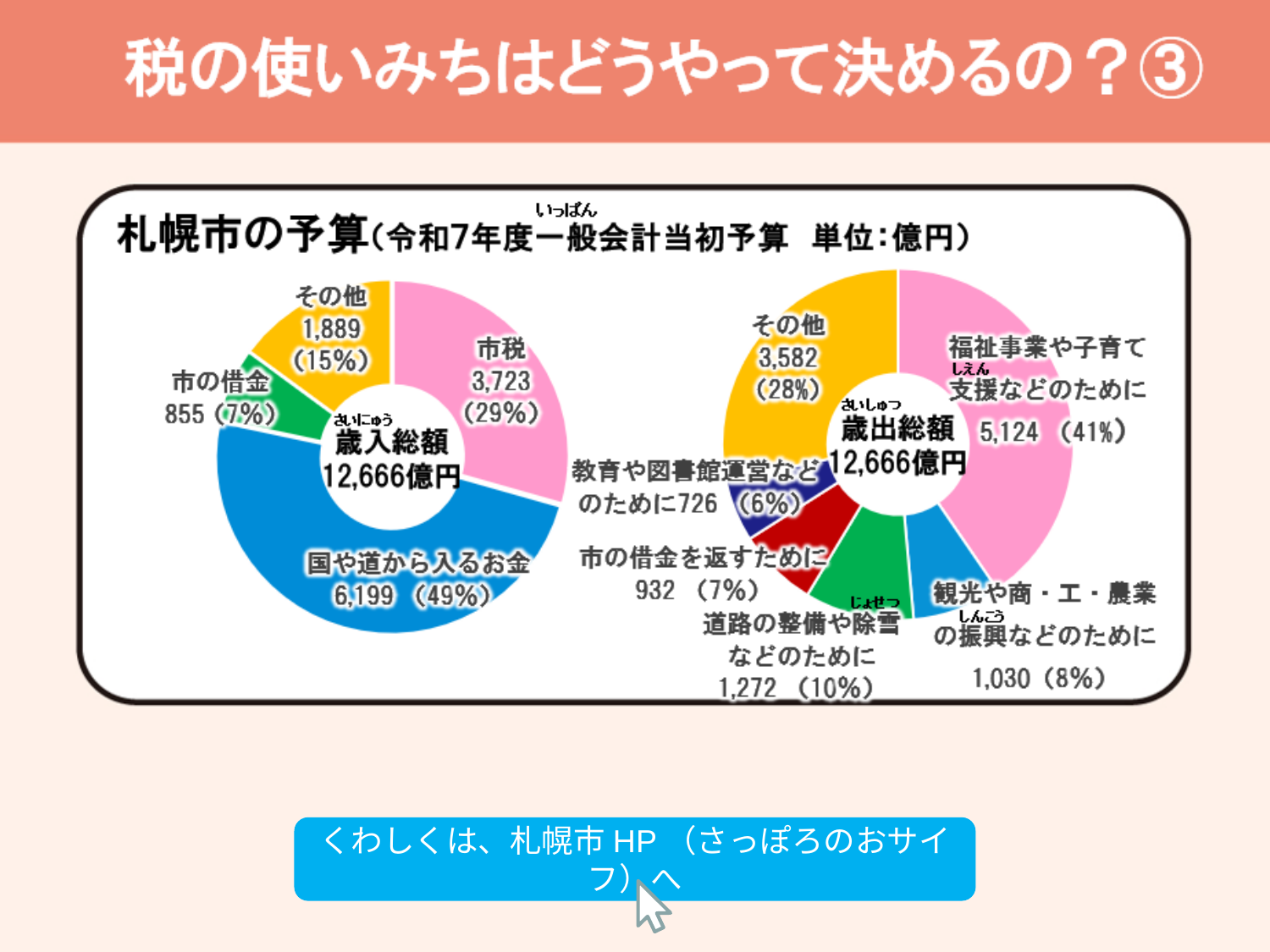
In the 歳出 chart on the right, what share of the total is その他? 28% In the 歳入 chart on the left, what is the difference between 国や道から入るお金 and 市税? 2,476 In the 歳出 chart on the right, which is larger: 道路の整備や除雪などのために or 市の借金を返すために? 道路の整備や除雪などのために In the 歳入 chart on the left, what share of the total is 国や道から入るお金? 49% In the 歳出 chart on the right, how many categories are shown? 6 In the 歳出 (expenditure) chart on the right, what is the value for 福祉事業や子育て支援などのために? 5,124 In the 歳入 chart on the left, how many categories are shown? 4 In the 歳入 (revenue) chart on the left, what is the value for 市税? 3,723 In the 歳入 chart on the left, which category is the smallest? 市の借金 In the 歳出 chart on the right, which category is the smallest? 教育や図書館運営などのために In the 歳出 chart on the right, which category is the largest? 福祉事業や子育て支援などのために What type of chart is used for the 歳入 and 歳出 figures on the slide? Pie (donut) chart